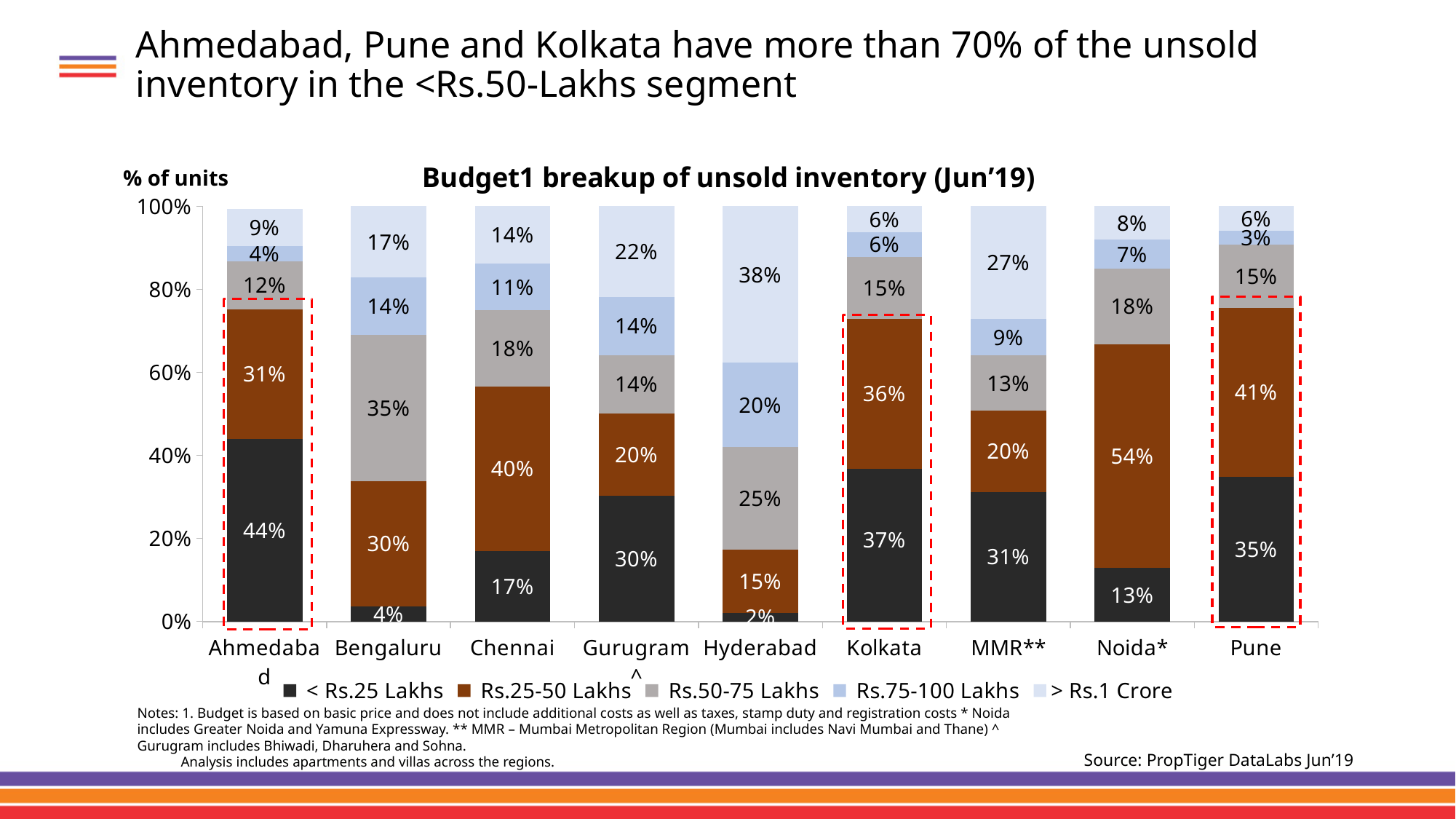
What percentage of Ahmedabad's unsold inventory is in the < Rs.25 Lakhs segment? 44% What is the difference in percentage points between Ahmedabad's and Pune's < Rs.25 Lakhs shares? 9 percentage points Which city has the highest share in the > Rs.1 Crore segment? Hyderabad Which has a larger Rs.50-75 Lakhs share, Bengaluru or Chennai? Bengaluru How many budget segments does the legend list? 5 What is the > Rs.1 Crore share for Hyderabad? 38% What is the combined share of the < Rs.25 Lakhs and Rs.25-50 Lakhs segments for Kolkata? 73% How many cities are shown on the x axis of the chart? 9 What type of chart is used to show the budget breakup of unsold inventory? Stacked bar chart Which city has the highest share in the < Rs.25 Lakhs segment? Ahmedabad Which city has the lowest share in the < Rs.25 Lakhs segment? Hyderabad What is the Rs.25-50 Lakhs share for Noida*? 54%